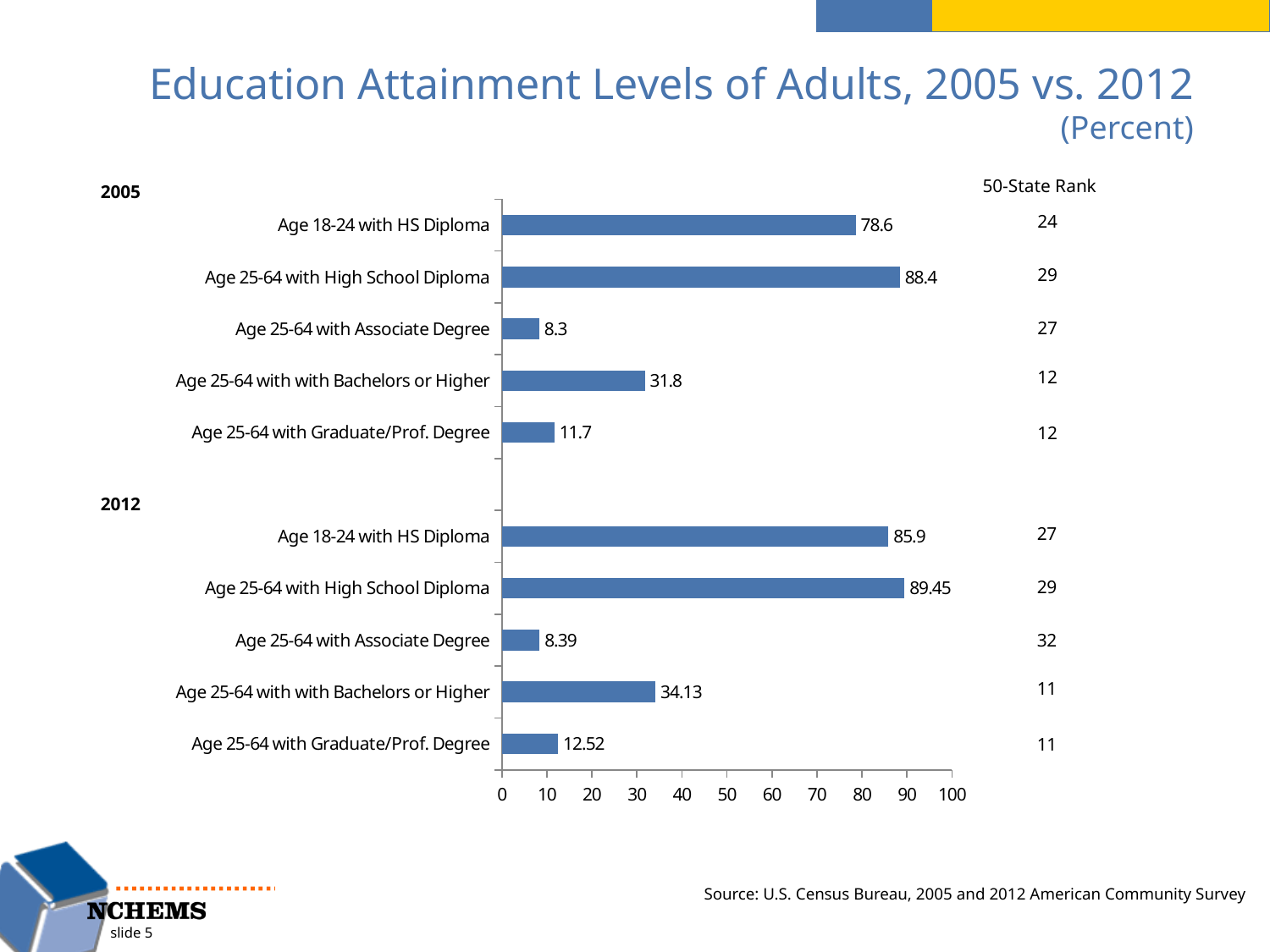
What is the value for Age 25-64 with Graduate/Prof. Degree in 2005? 11.7 Which category has the highest value in the 2005 group? Age 25-64 with High School Diploma Which category has the lowest value in the 2012 group? Age 25-64 with Associate Degree What is the difference between the 2012 and 2005 values for Age 25-64 with with Bachelors or Higher? 2.33 What is the value for Age 18-24 with HS Diploma in 2012? 85.9 What kind of chart is shown on the slide? Bar chart What is the value for Age 25-64 with High School Diploma in 2005? 88.4 Which is larger: the 2005 value for Age 25-64 with Associate Degree or the 2005 value for Age 25-64 with Graduate/Prof. Degree? Age 25-64 with Graduate/Prof. Degree What is the value for Age 25-64 with with Bachelors or Higher in 2012? 34.13 How many bars are plotted in the chart in total across both years? 10 What is the 50-State Rank shown for Age 25-64 with Associate Degree in 2012? 32 How much higher is the value for Age 18-24 with HS Diploma in 2012 than in 2005? 7.3